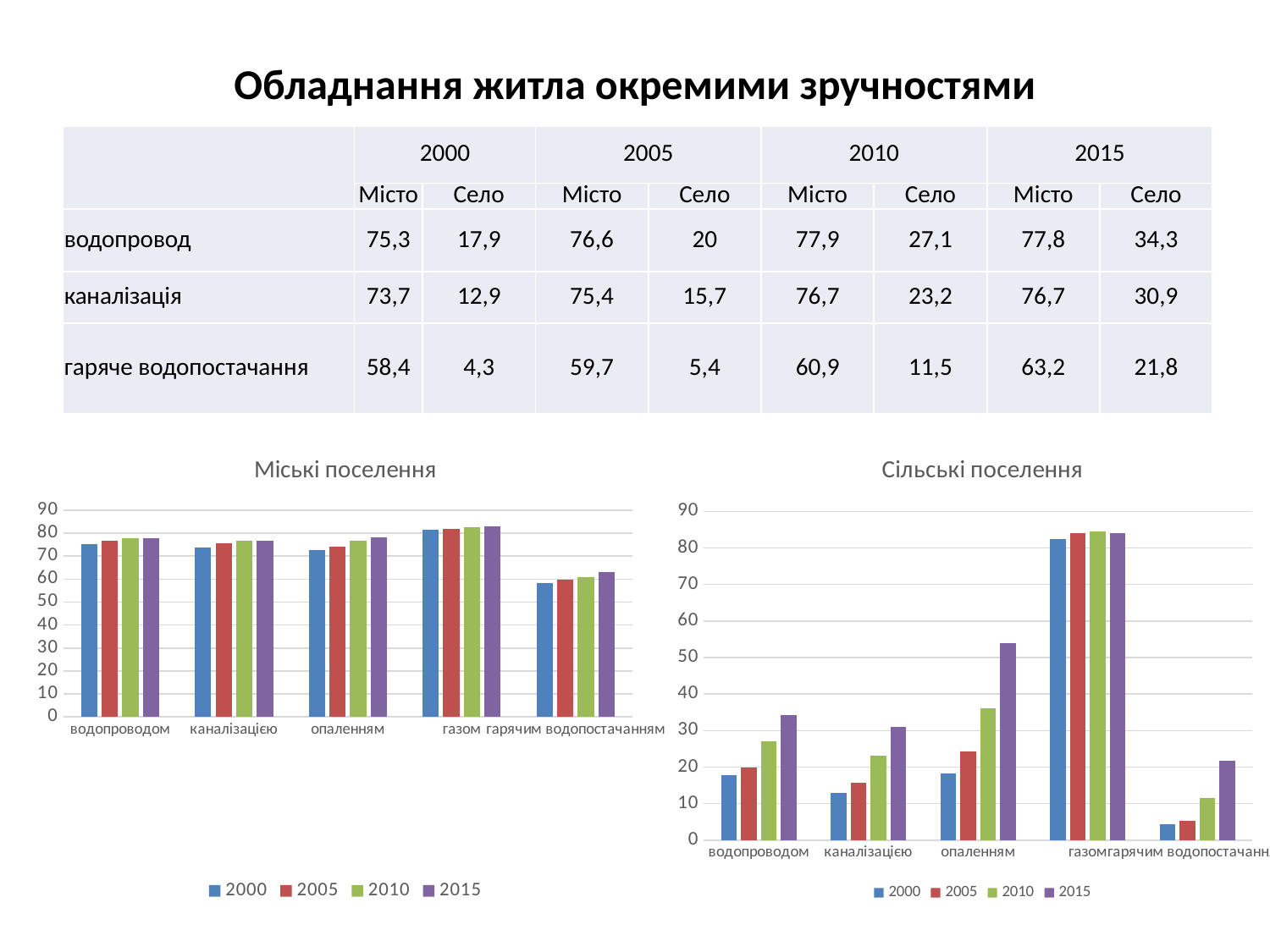
What colour represents the 2015 series in the 'Міські поселення' chart? purple In the 'Сільські поселення' chart, is the 2015 value for опаленням greater or less than 50? greater In the 'Міські поселення' chart, which is larger for 2015: газом or водопроводом? газом What kind of chart is the 'Міські поселення' chart? bar chart In the 'Сільські поселення' chart, do the values for водопроводом rise or fall from 2000 to 2015? rise How many series does the legend of the 'Сільські поселення' chart list? 4 How many categories are shown on the x axis of the 'Міські поселення' chart? 5 In the 'Міські поселення' chart, is the 2000 value for гарячим водопостачанням greater or less than 70? less In the 'Сільські поселення' chart, which category has the lowest value for 2000? гарячим водопостачанням In the 'Сільські поселення' chart, is the 2000 value for каналізацією greater or less than 20? less In the 'Міські поселення' chart, which category has the highest value for 2000? газом In the 'Сільські поселення' chart, which category has the highest value for 2015? газом